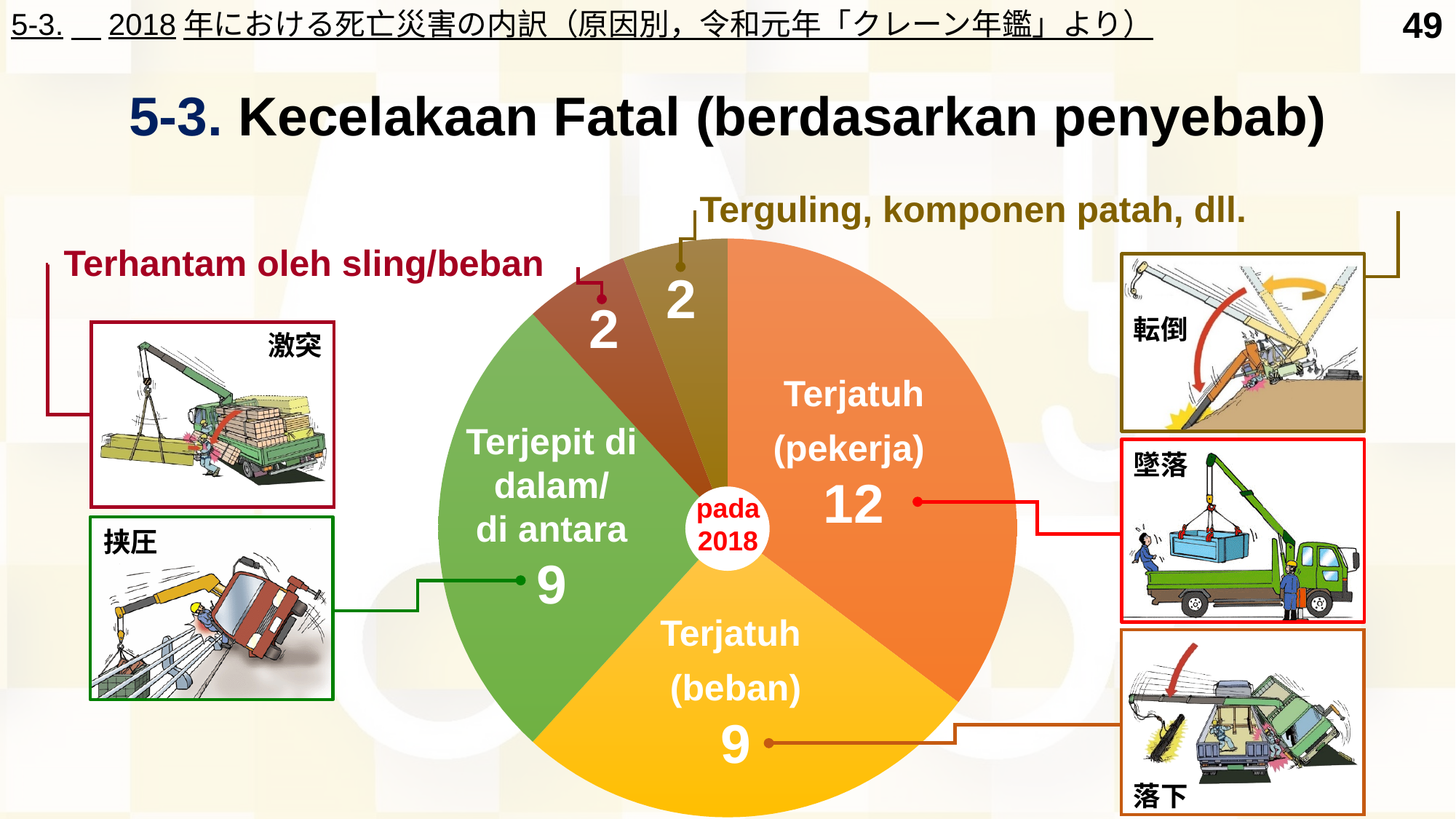
Which is larger, the value for Terjatuh (pekerja) or the value for Terjepit di dalam/di antara? Terjatuh (pekerja) What year label is shown in the centre of the pie chart? pada 2018 What is the value for Terhantam oleh sling/beban? 2 How many categories (slices) does the pie chart have? 5 What is the value for Terjatuh (pekerja)? 12 What is the value for Terguling, komponen patah, dll.? 2 What is the total of all the values in the pie chart? 34 What is the difference between the values for Terjatuh (pekerja) and Terjatuh (beban)? 3 What is the value for Terjepit di dalam/di antara? 9 Which category has the highest value in the pie chart? Terjatuh (pekerja) What is the value for Terjatuh (beban)? 9 What kind of chart is shown on the slide? pie chart